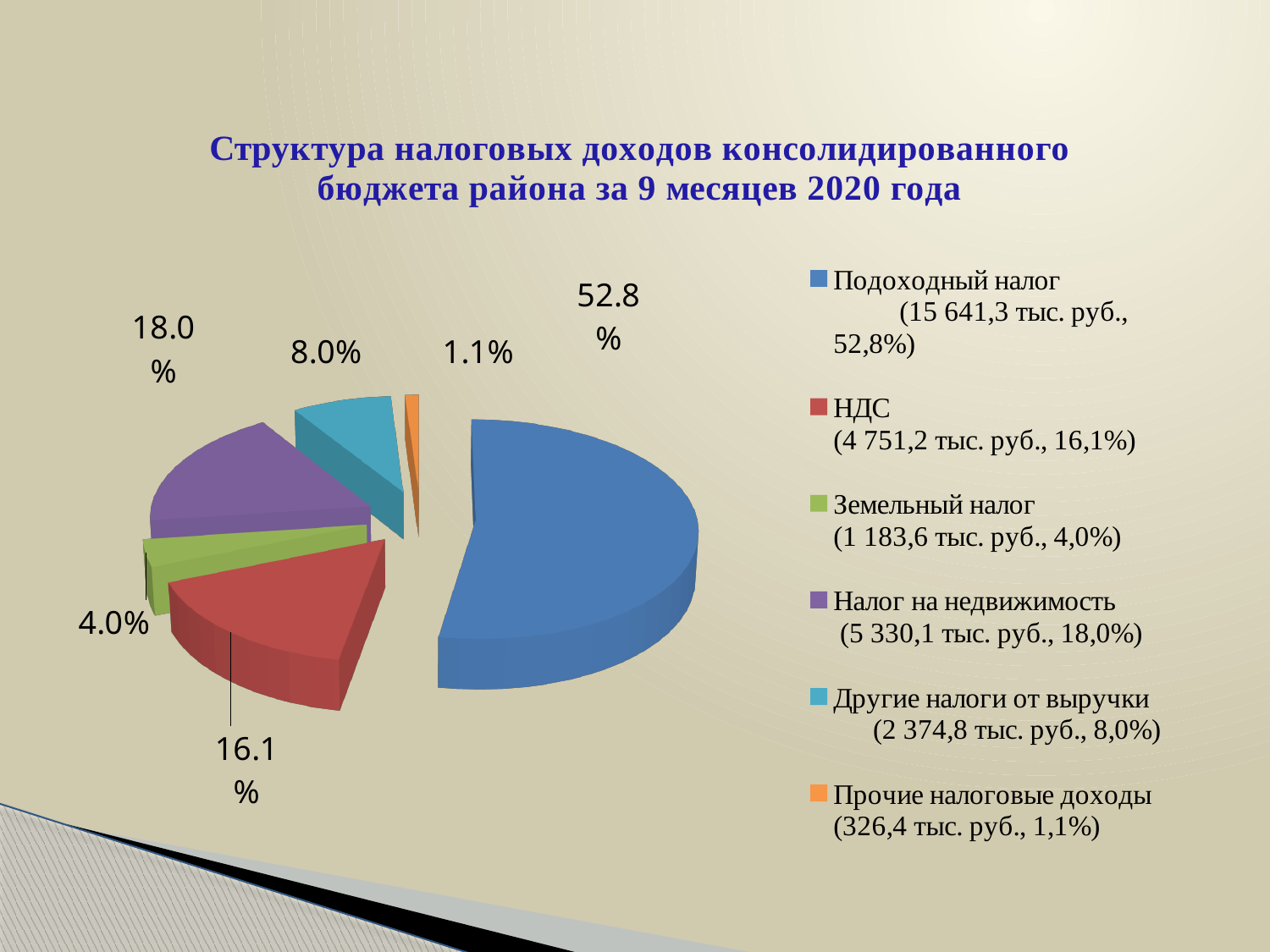
By how many percentage points does the Подоходный налог share exceed the НДС share? 36.7 What is the data label shown for НДС? 16.1% Which category has the smallest slice of the pie? Прочие налоговые доходы What share of the pie does Подоходный налог take? 52.8% What share of the pie does Налог на недвижимость take? 18.0% What kind of chart is shown on the slide? pie chart What is the title of the chart? Структура налоговых доходов консолидированного бюджета района за 9 месяцев 2020 года How many slices does the pie chart have? 6 What is the data label shown for Прочие налоговые доходы? 1.1% According to the legend, what amount in тыс. руб. is given for Земельный налог? 1 183,6 тыс. руб. Which slice is larger: Налог на недвижимость or Другие налоги от выручки? Налог на недвижимость Which category has the largest slice of the pie? Подоходный налог